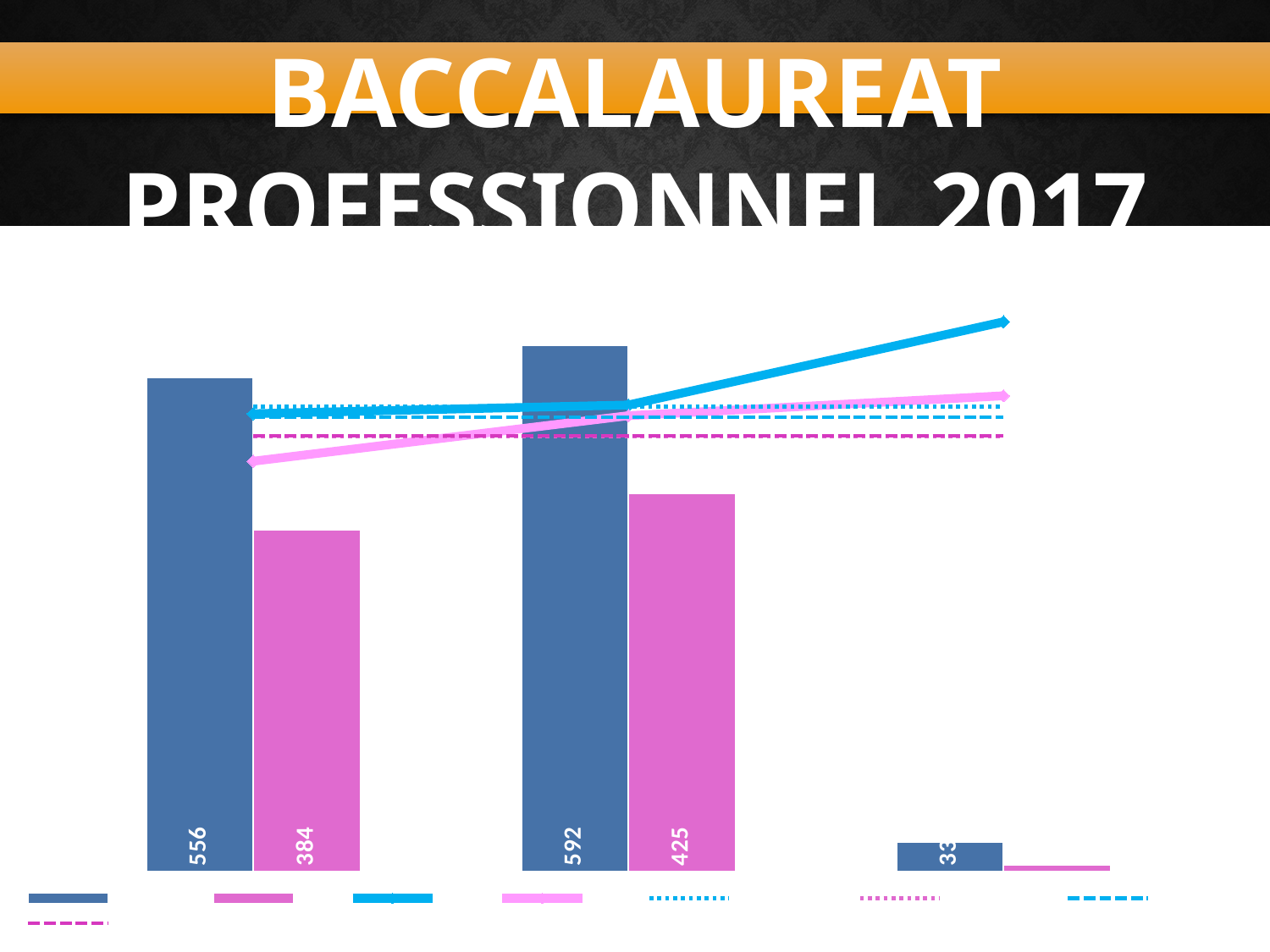
What is the title of the slide containing the chart? BACCALAUREAT PROFESSIONNEL 2017 What is the value of the blue bar in the second group of bars? 592 Which group of bars has the tallest blue bar? The second group What is the difference between the blue bar in the second group and the blue bar in the first group? 36 Which is larger: the blue bar in the first group or the pink bar in the second group? The blue bar in the first group How many groups of bars are plotted on the chart? 3 What is the value of the pink bar in the second group of bars? 425 What is the value of the pink bar in the first group of bars? 384 What is the difference between the blue bar and the pink bar in the second group? 167 What is the value of the blue bar in the first group of bars? 556 Does the solid blue line rise or fall from left to right? Rises What is the difference between the blue bar and the pink bar in the first group? 172